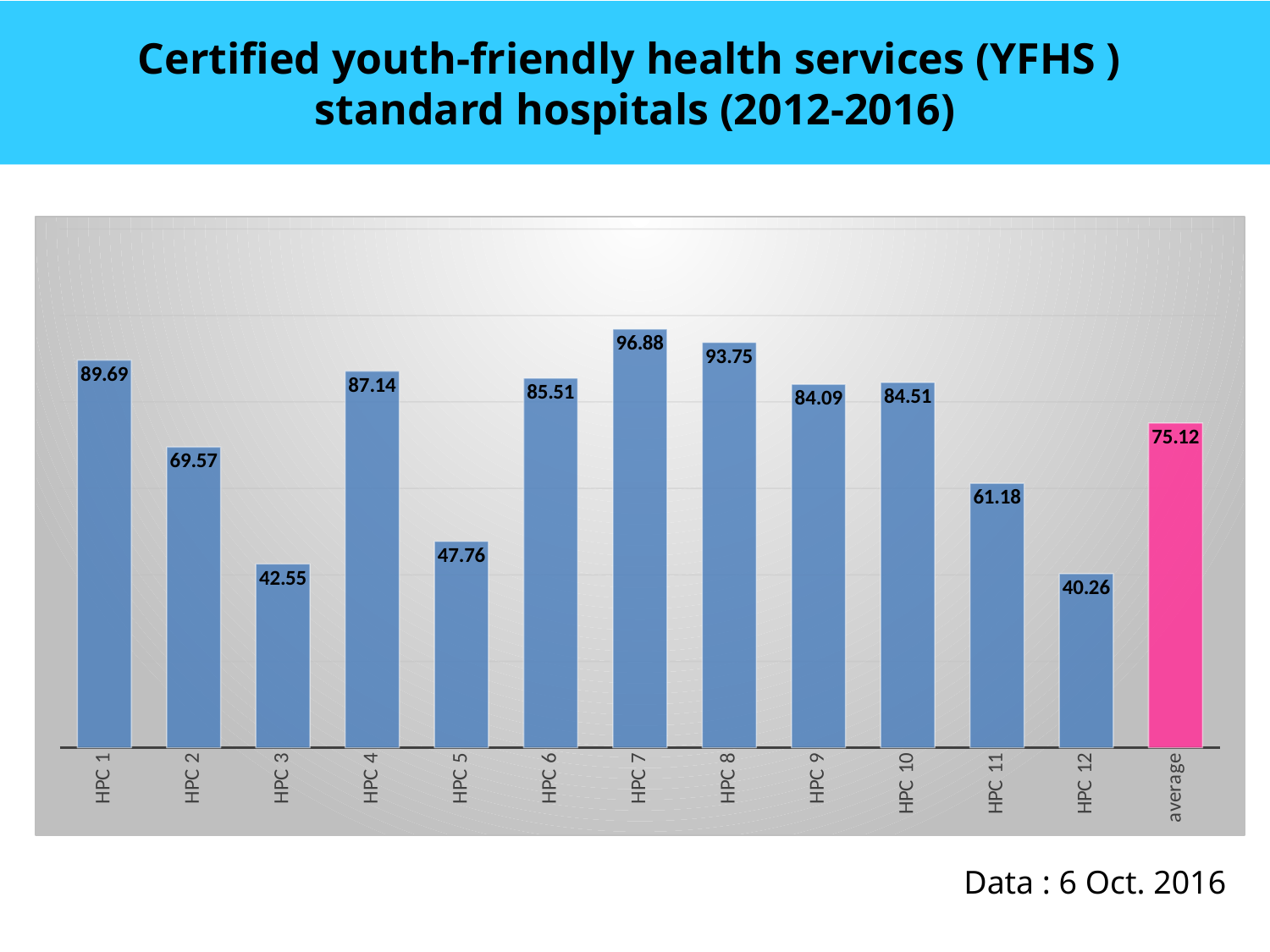
How many bars are plotted on the chart, including the average bar? 13 Which is larger, the value for HPC 2 or the value for HPC 11? HPC 2 Which category has the lowest value? HPC 12 Which category has the highest value? HPC 7 What is the value for HPC 3? 42.55 What is the value shown for the average bar? 75.12 What is the difference between the values for HPC 7 and HPC 12? 56.62 Which is larger, the value for HPC 8 or the value for HPC 1? HPC 8 What is the value for HPC 7? 96.88 What is the difference between the value for HPC 1 and the average value? 14.57 What kind of chart is shown on the slide? Bar chart Which bar is coloured pink instead of blue? average